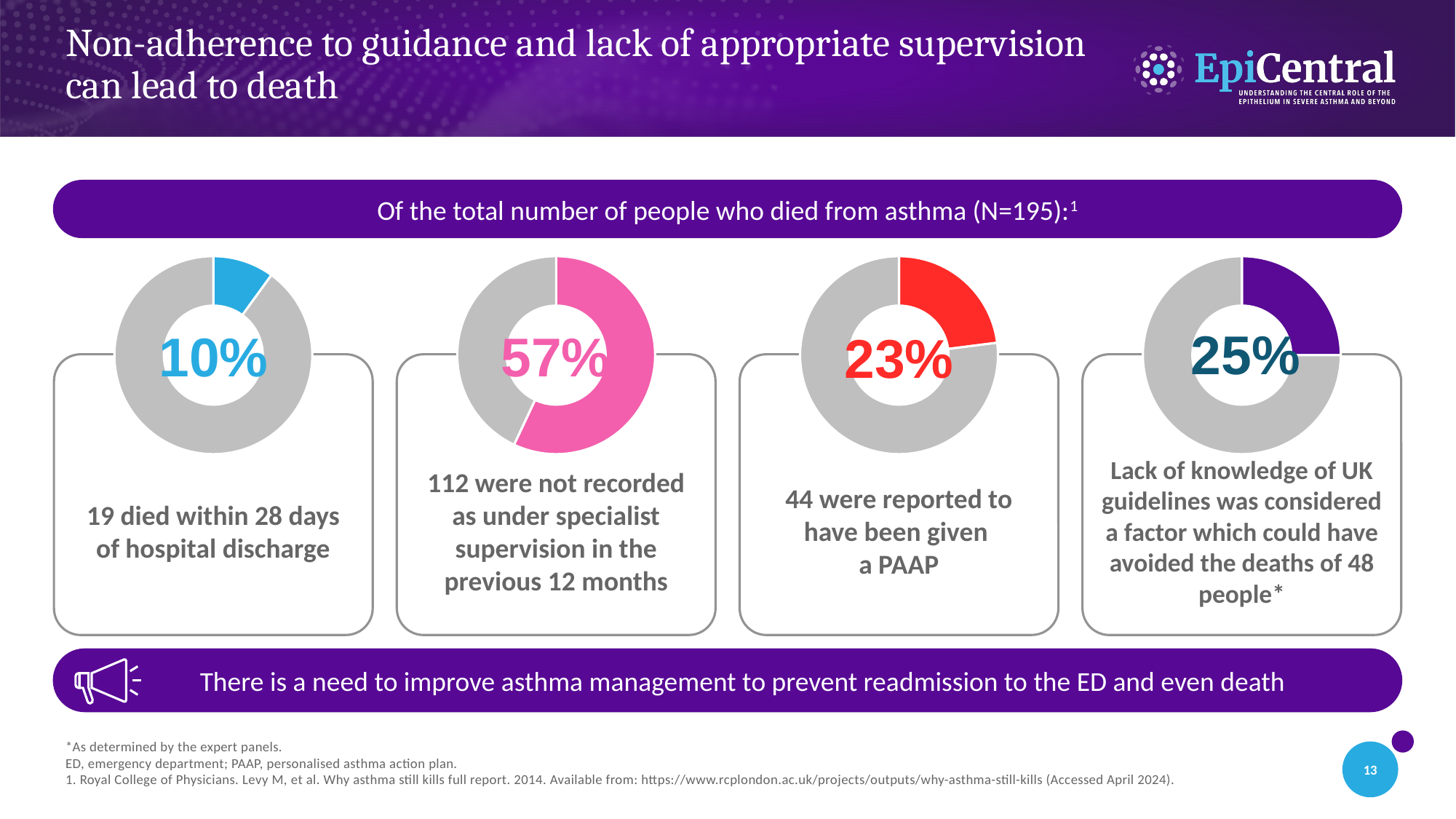
Which is larger: the percentage in the PAAP donut chart or the percentage in the rightmost UK guidelines donut chart? The UK guidelines donut chart (25%) How many donut charts are shown on the slide? 4 What percentage is shown in the donut chart for people not recorded as under specialist supervision in the previous 12 months? 57% Which of the four donut charts shows the highest percentage? The second from left (not recorded as under specialist supervision), 57% What percentage is shown in the donut chart for people reported to have been given a PAAP? 23% Is the value shown in the second donut chart from the left greater or less than 50%? greater What percentage is shown in the leftmost donut chart (19 died within 28 days of hospital discharge)? 10% What is the difference in percentage points between the specialist supervision donut (57%) and the PAAP donut (23%)? 34 percentage points Which of the four donut charts shows the lowest percentage? The leftmost (died within 28 days of hospital discharge), 10% What colour is the highlighted slice in the leftmost donut chart? Blue What percentage is shown in the rightmost donut chart (lack of knowledge of UK guidelines)? 25% What kind of chart is used to display the percentages on this slide? Donut (pie) chart